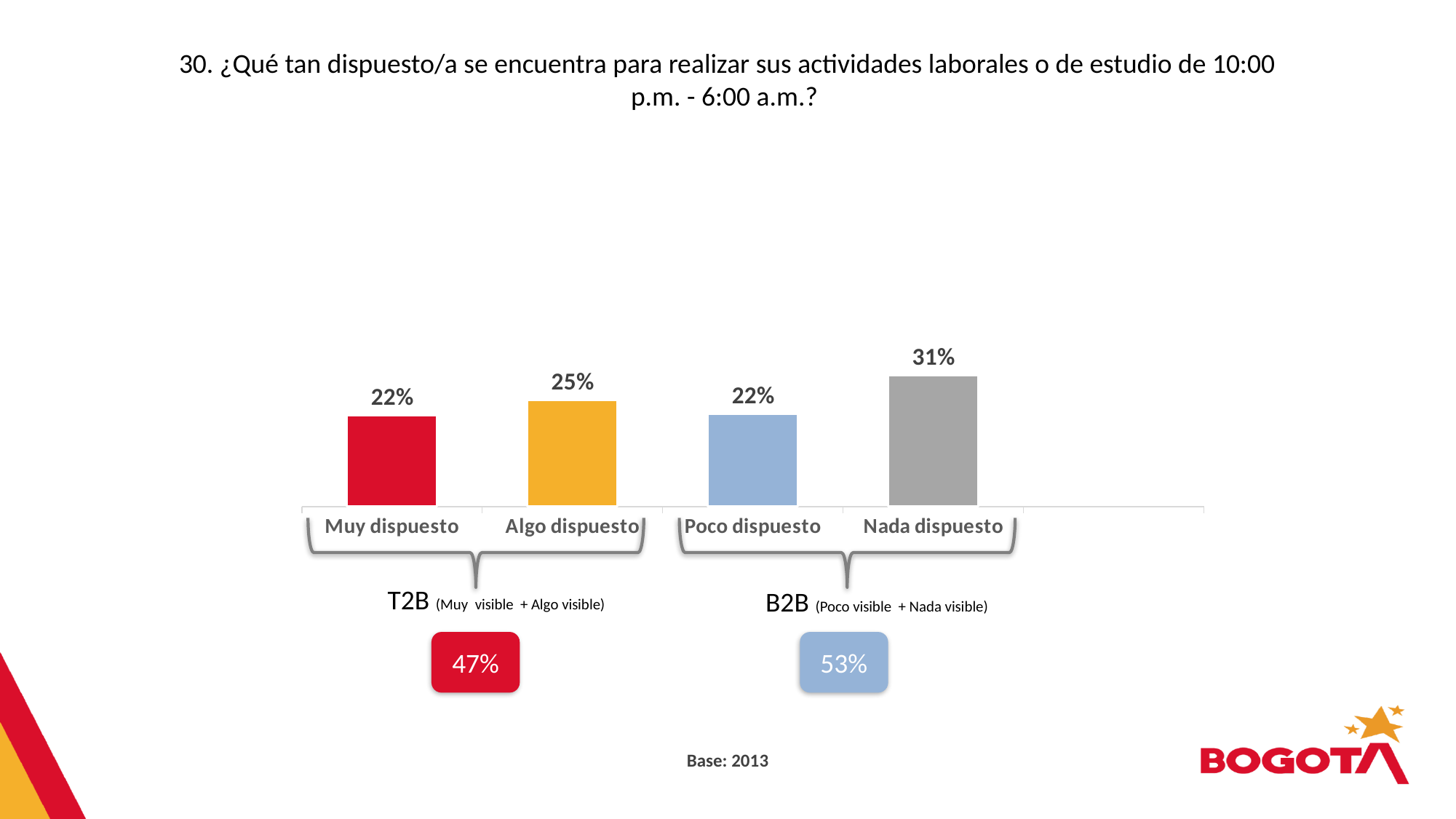
What is the value for Algo dispuesto? 25% What is the value for Muy dispuesto? 22% What is the B2B value shown below the chart? 53% What is the value for Nada dispuesto? 31% What kind of chart is shown on the slide? Bar chart Which is larger, Algo dispuesto or Muy dispuesto? Algo dispuesto What colour is the bar for Nada dispuesto? Grey What is the difference between Nada dispuesto and Algo dispuesto? 6% What is the T2B value shown below the chart? 47% Which category has the highest value? Nada dispuesto What is the difference between Algo dispuesto and Poco dispuesto? 3% How many categories are shown in the chart? 4